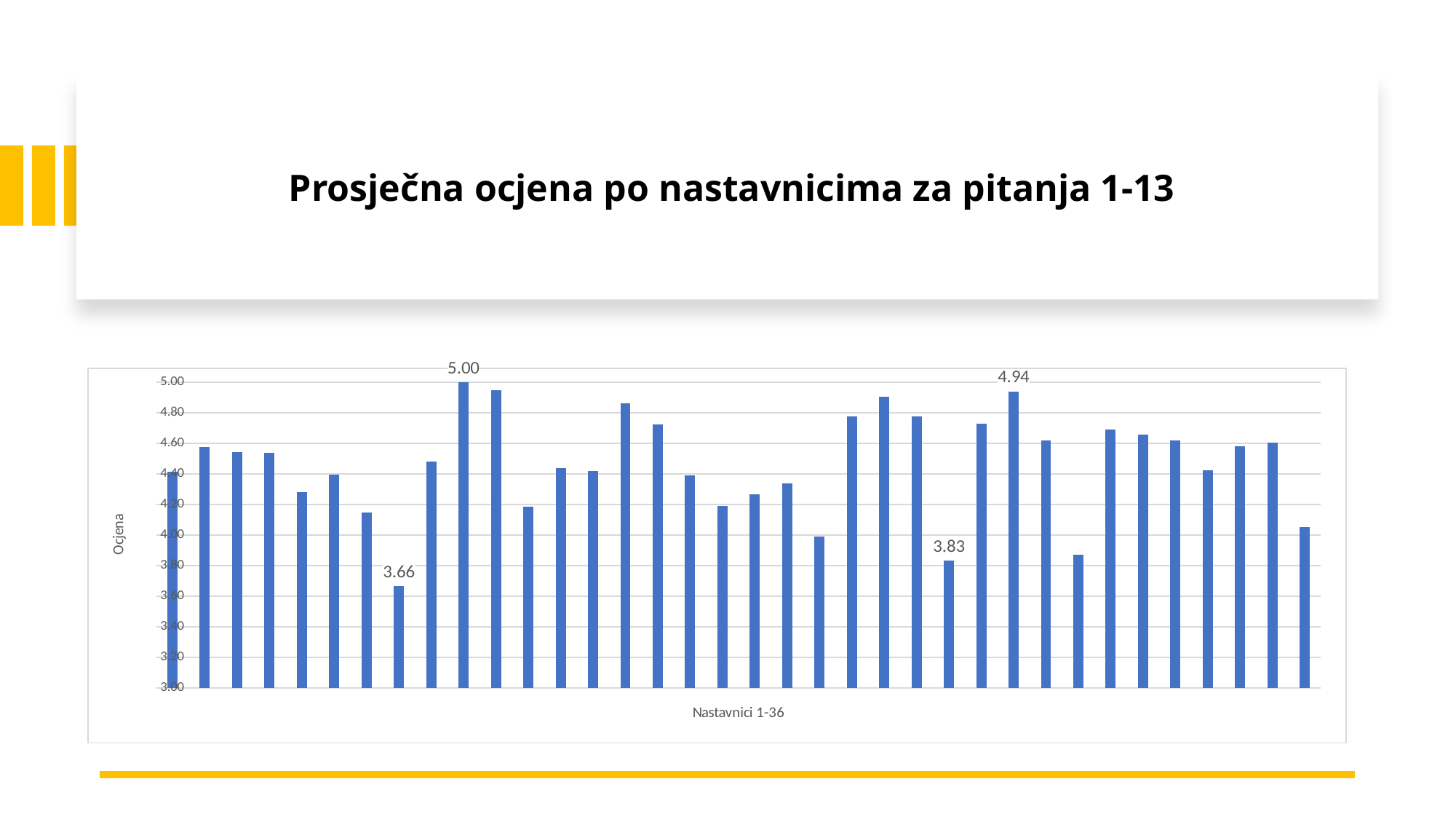
How many bars (teachers) are plotted in the chart? 36 What is the highest value labelled on the chart? 5.00 What is the value of the 8th bar from the left? 3.66 What is the difference between the highest labelled value (5.00) and the lowest labelled value (3.66)? 1.34 Which is larger, the bar labelled 5.00 or the bar labelled 4.94? 5.00 What is the title of the chart? Prosječna ocjena po nastavnicima za pitanja 1-13 Is the value for the 29th bar from the left greater or less than 4.00? less What is the lowest value labelled on the chart? 3.66 What is the value of the 10th bar from the left? 5.00 What is the value of the 25th bar from the left? 3.83 What kind of chart is shown on the slide? bar chart What is the label of the vertical axis? Ocjena